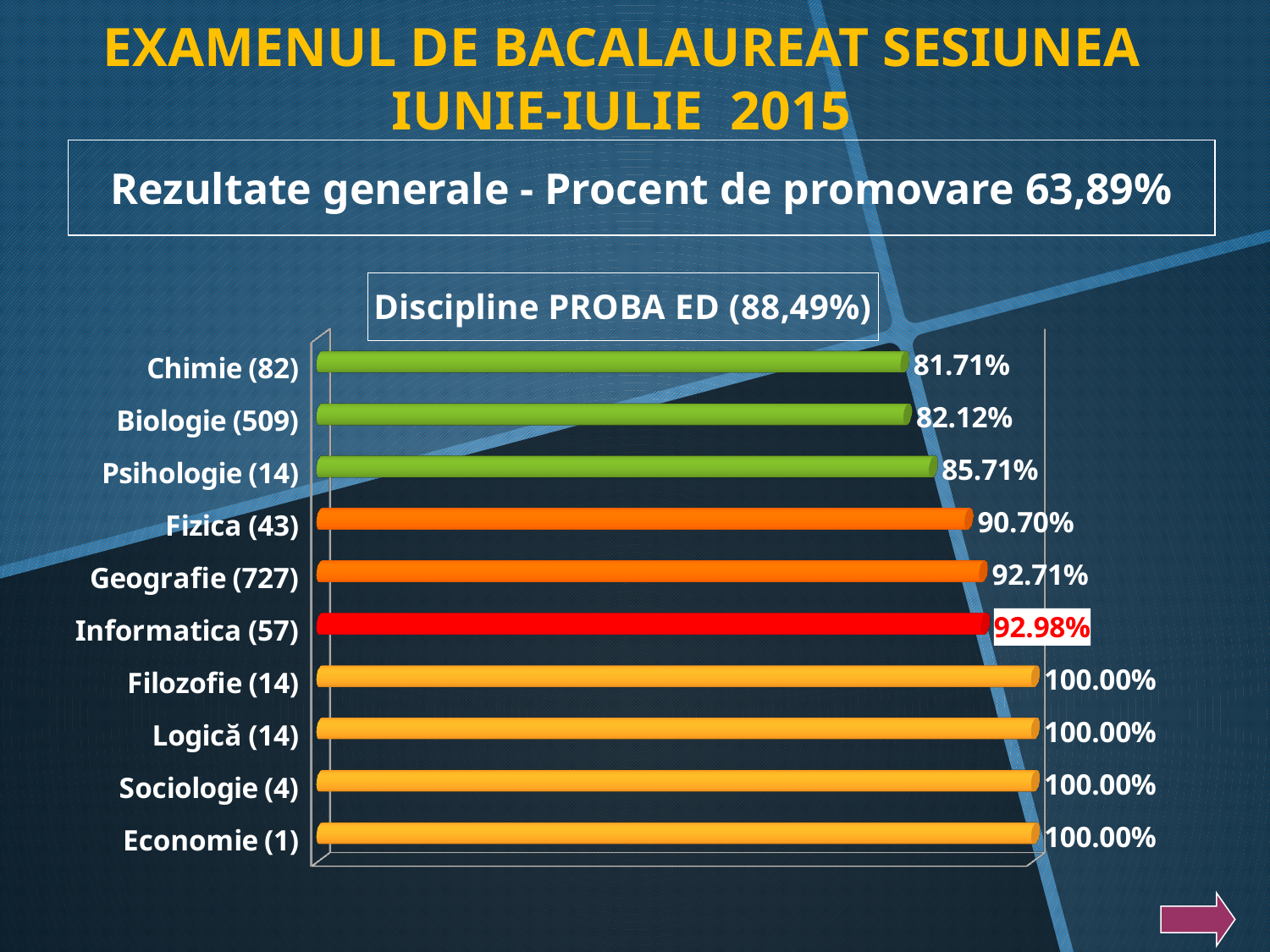
What is the value for Chimie (82)? 81.71% What is the difference between the values for Filozofie (14) and Fizica (43)? 9.30% What is the value for Fizica (43)? 90.70% How many categories are shown in the chart? 10 How many categories have a value of 100.00%? 4 What is the value for Geografie (727)? 92.71% What is the value for Informatica (57)? 92.98% Which is larger, the value for Psihologie (14) or the value for Fizica (43)? Fizica (43) What is the difference between the values for Psihologie (14) and Biologie (509)? 3.59% What kind of chart is shown on the slide? Bar chart Which category has the lowest value? Chimie (82) What is the title of the chart? Discipline PROBA ED (88,49%)